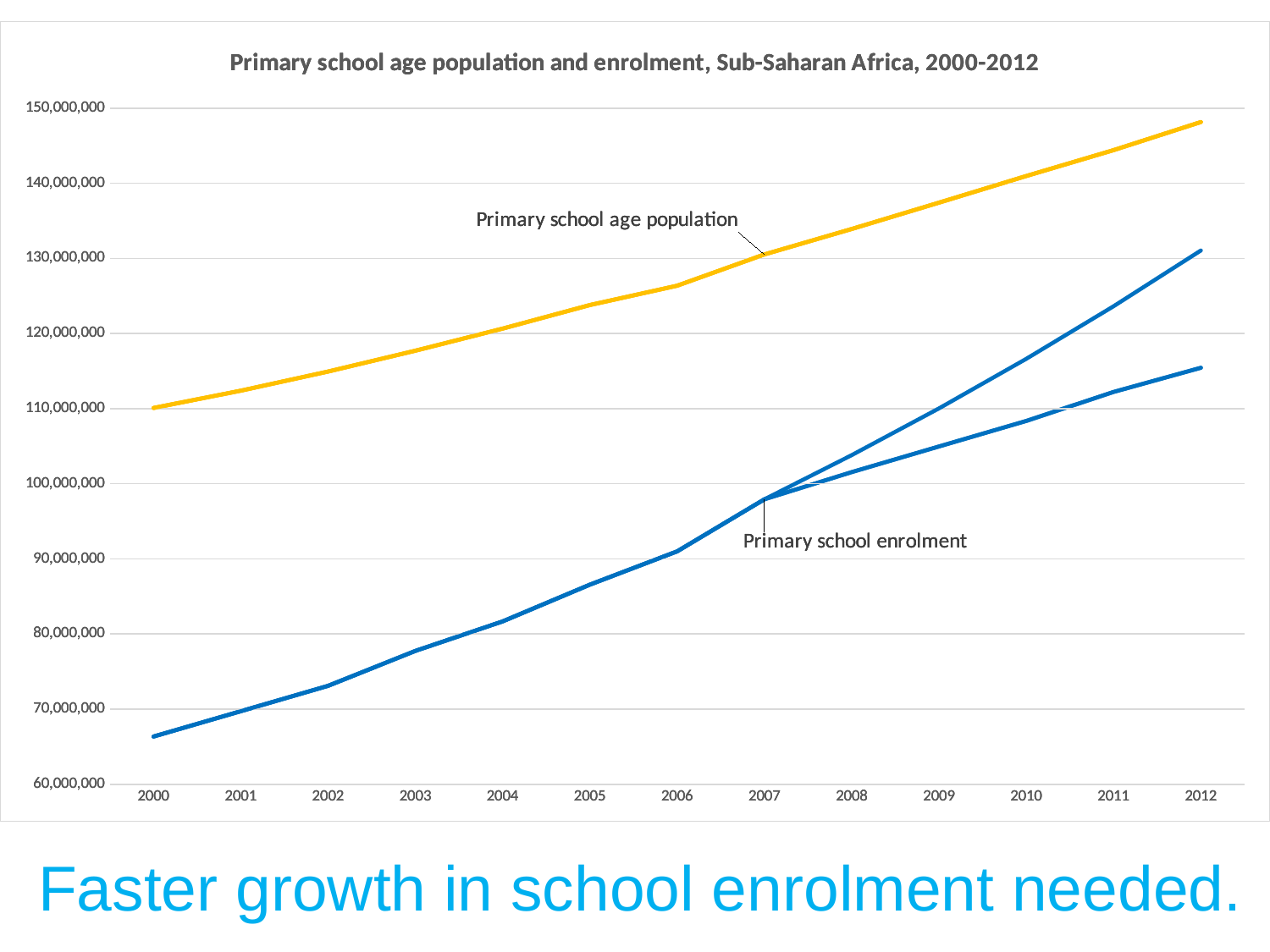
Is the value for Primary school age population in 2012 greater or less than 140,000,000? greater What colour is the line for Primary school age population? Yellow Is the value for Primary school age population in 2006 greater or less than 120,000,000? greater What kind of chart is shown on the slide? Line chart How many years are shown along the x axis of the chart? 13 Is the value for Primary school age population in 2012 greater or less than 150,000,000? less In which year is the Primary school age population lowest? 2000 What is the title of the chart? Primary school age population and enrolment, Sub-Saharan Africa, 2000-2012 Which is larger in 2012, Primary school age population or Primary school enrolment? Primary school age population Does the Primary school age population line rise or fall from 2000 to 2012? Rise